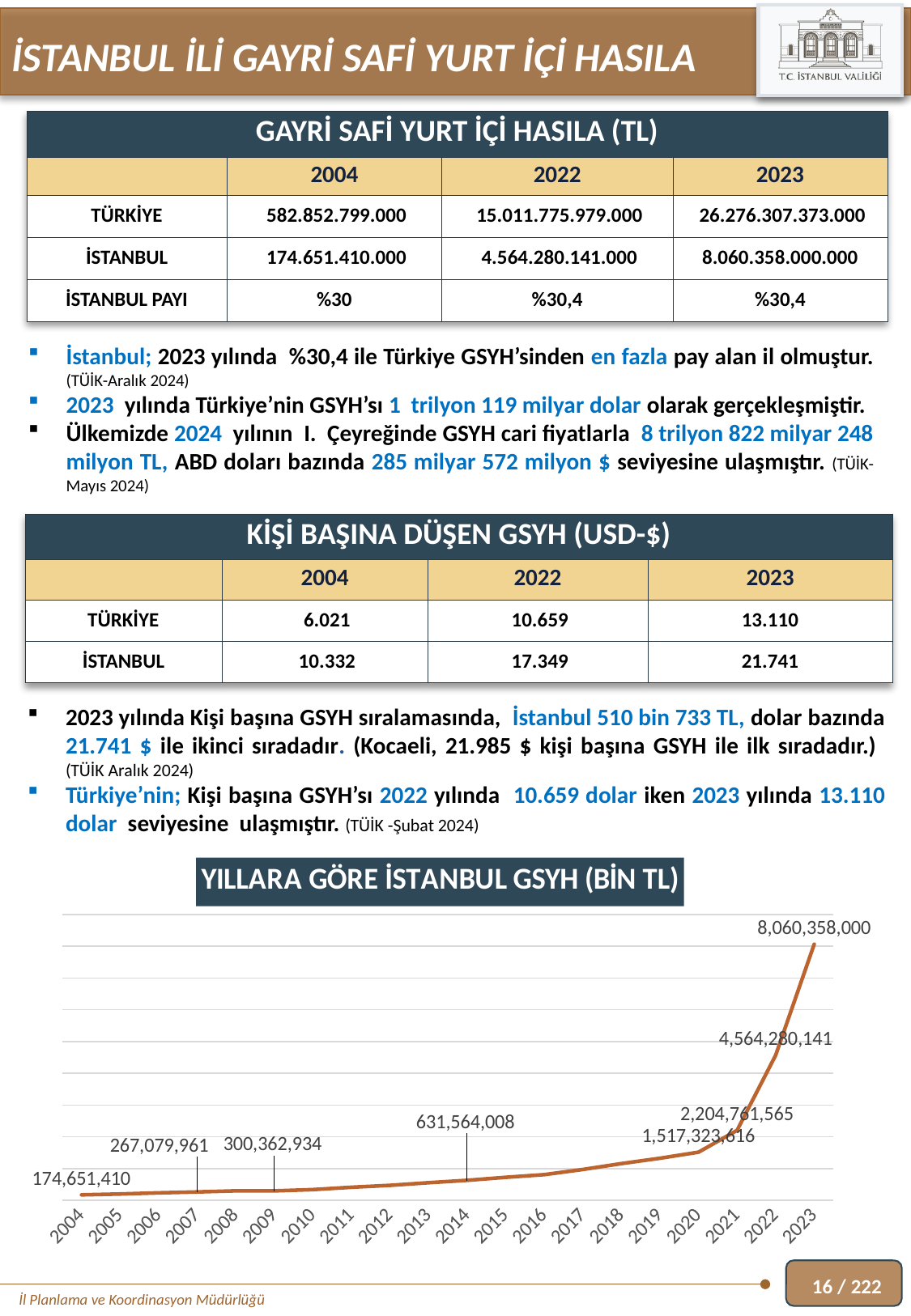
In the chart "YILLARA GÖRE İSTANBUL GSYH (BİN TL)", what is the value for 2004? 174,651,410 In the chart "YILLARA GÖRE İSTANBUL GSYH (BİN TL)", what is the value for 2023? 8,060,358,000 In the chart "YILLARA GÖRE İSTANBUL GSYH (BİN TL)", what is the difference between the 2023 and 2022 values? 3,496,077,859 In the chart "YILLARA GÖRE İSTANBUL GSYH (BİN TL)", what is the value labelled for 2007? 267,079,961 In the chart "YILLARA GÖRE İSTANBUL GSYH (BİN TL)", what is the difference between the 2009 and 2007 values? 33,282,973 In the chart "YILLARA GÖRE İSTANBUL GSYH (BİN TL)", which year has the lowest value? 2004 In the chart "YILLARA GÖRE İSTANBUL GSYH (BİN TL)", do the values rise or fall from 2004 to 2023? rise What kind of chart is "YILLARA GÖRE İSTANBUL GSYH (BİN TL)"? line chart In the chart "YILLARA GÖRE İSTANBUL GSYH (BİN TL)", how many years are shown on the x axis? 20 In the chart "YILLARA GÖRE İSTANBUL GSYH (BİN TL)", what is the value for 2022? 4,564,280,141 In the chart "YILLARA GÖRE İSTANBUL GSYH (BİN TL)", what is the value labelled for 2014? 631,564,008 In the chart "YILLARA GÖRE İSTANBUL GSYH (BİN TL)", which year has the highest value? 2023